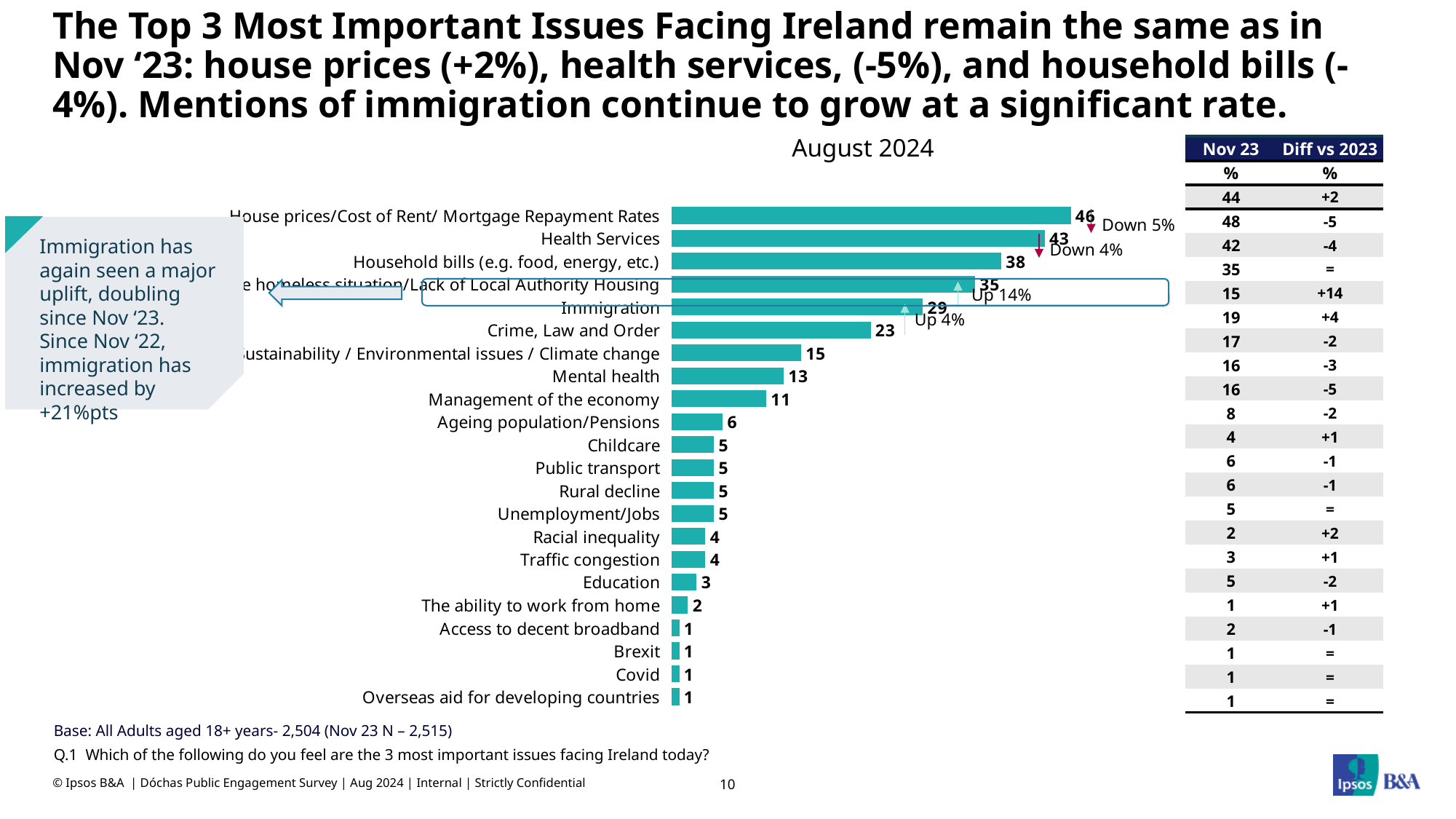
What is the difference between the values for Immigration and Crime, Law and Order? 6 What is the value for Mental health? 13 Which has a larger value, Management of the economy or Mental health? Mental health What is the title shown above the bar chart? August 2024 How many categories are plotted in the August 2024 chart? 22 What is the value for Health Services in the August 2024 chart? 43 Which category has the highest value in the August 2024 chart? House prices/Cost of Rent/ Mortgage Repayment Rates What is the value for Ageing population/Pensions? 6 What is the value for Immigration in the August 2024 chart? 29 What type of chart is shown on the slide? bar chart What is the difference between the values for House prices/Cost of Rent/ Mortgage Repayment Rates and Household bills (e.g. food, energy, etc.)? 8 What is the value for Crime, Law and Order? 23